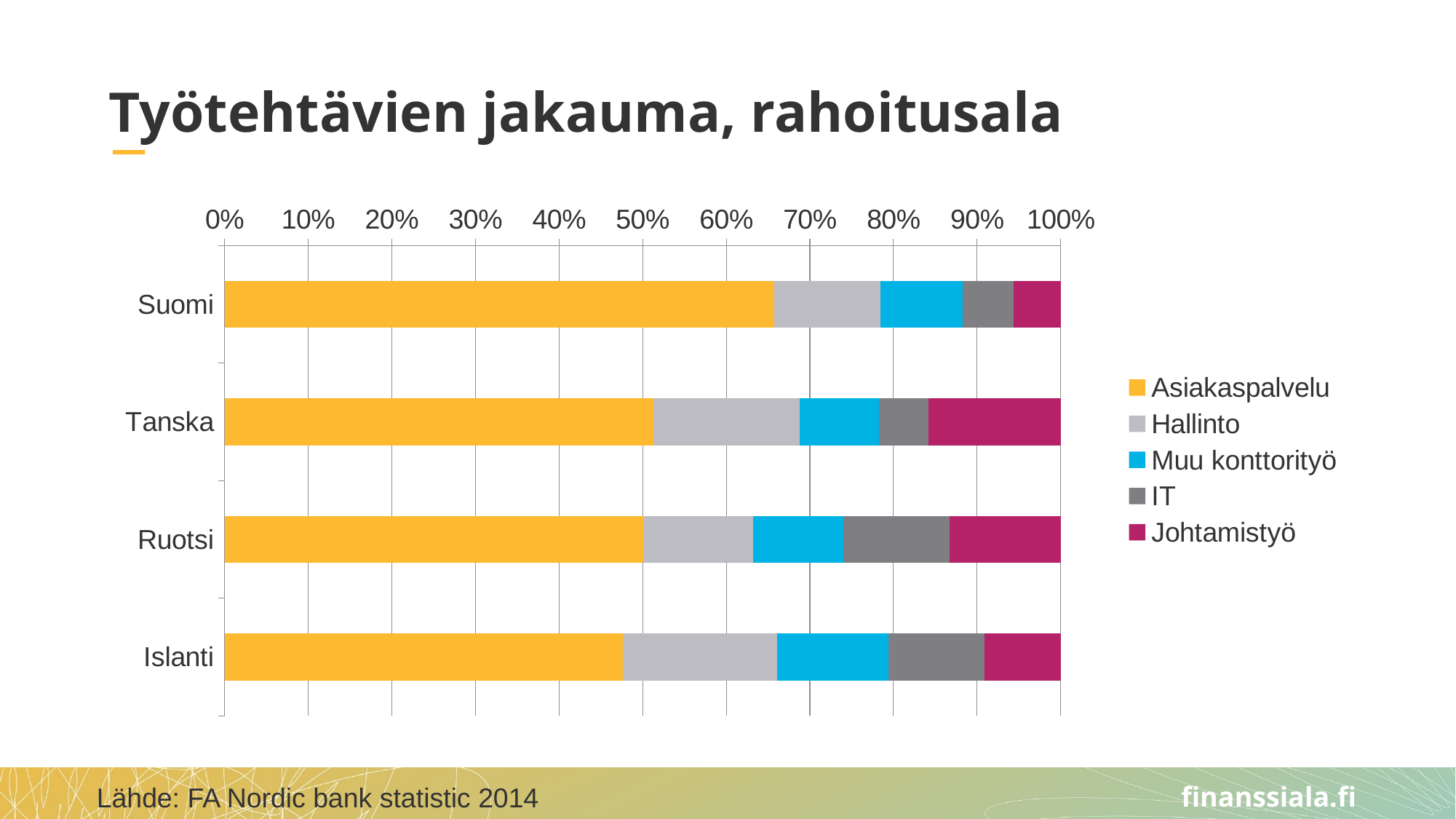
Which country has the largest Asiakaspalvelu share? Suomi Which country has the smallest Johtamistyö share? Suomi Is the Asiakaspalvelu share for Suomi greater or less than 60%? greater What kind of chart is shown on the slide? Stacked bar chart Which series is shown in orange in the legend? Asiakaspalvelu Which country has the largest Johtamistyö share? Tanska How many countries are shown on the chart? 4 How many series does the legend list? 5 What is the title of the chart on the slide? Työtehtävien jakauma, rahoitusala Which is larger, the Johtamistyö share for Tanska or for Suomi? Tanska Is the Asiakaspalvelu share for Islanti greater or less than 60%? less Which is larger, the IT share for Ruotsi or for Tanska? Ruotsi